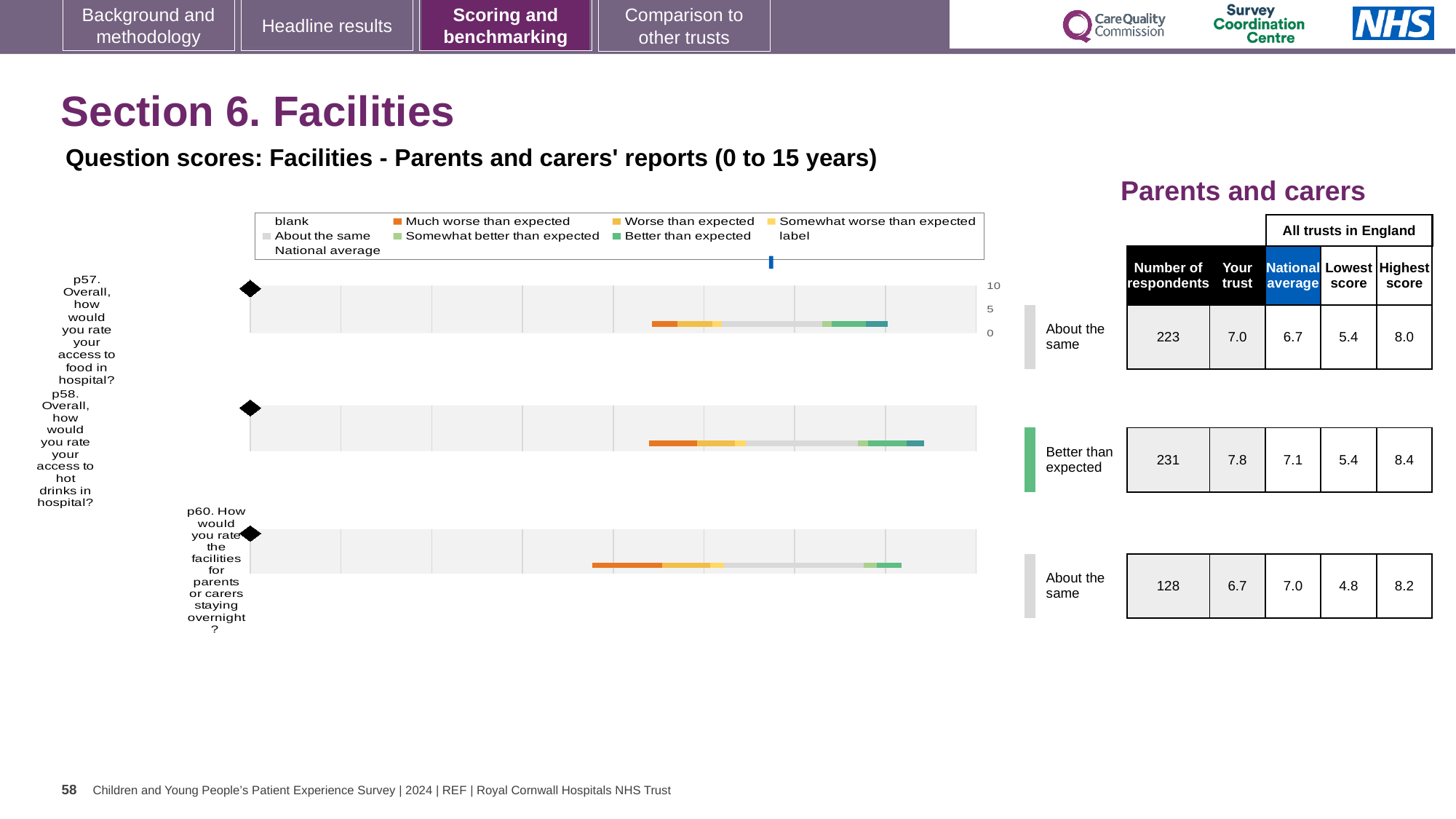
What kind of chart is used to show the question scores for Facilities? Bar chart How many respondents answered p60 (facilities for parents or carers staying overnight)? 128 What is the highest score among all trusts in England for p58? 8.4 What is the national average score for p58 (access to hot drinks in hospital)? 7.1 Which benchmark category is p58 (access to hot drinks) placed in? Better than expected Which question has the highest 'Your trust' score? p58 How many questions are plotted in the Facilities chart? 3 What is the 'Your trust' score for p57 (access to food in hospital)? 7.0 What is the lowest score among all trusts in England for p60? 4.8 What is the difference between the 'Your trust' score and the national average for p58? 0.7 For p57, which is larger: the 'Your trust' score or the national average? Your trust Which question has the lowest 'Your trust' score? p60